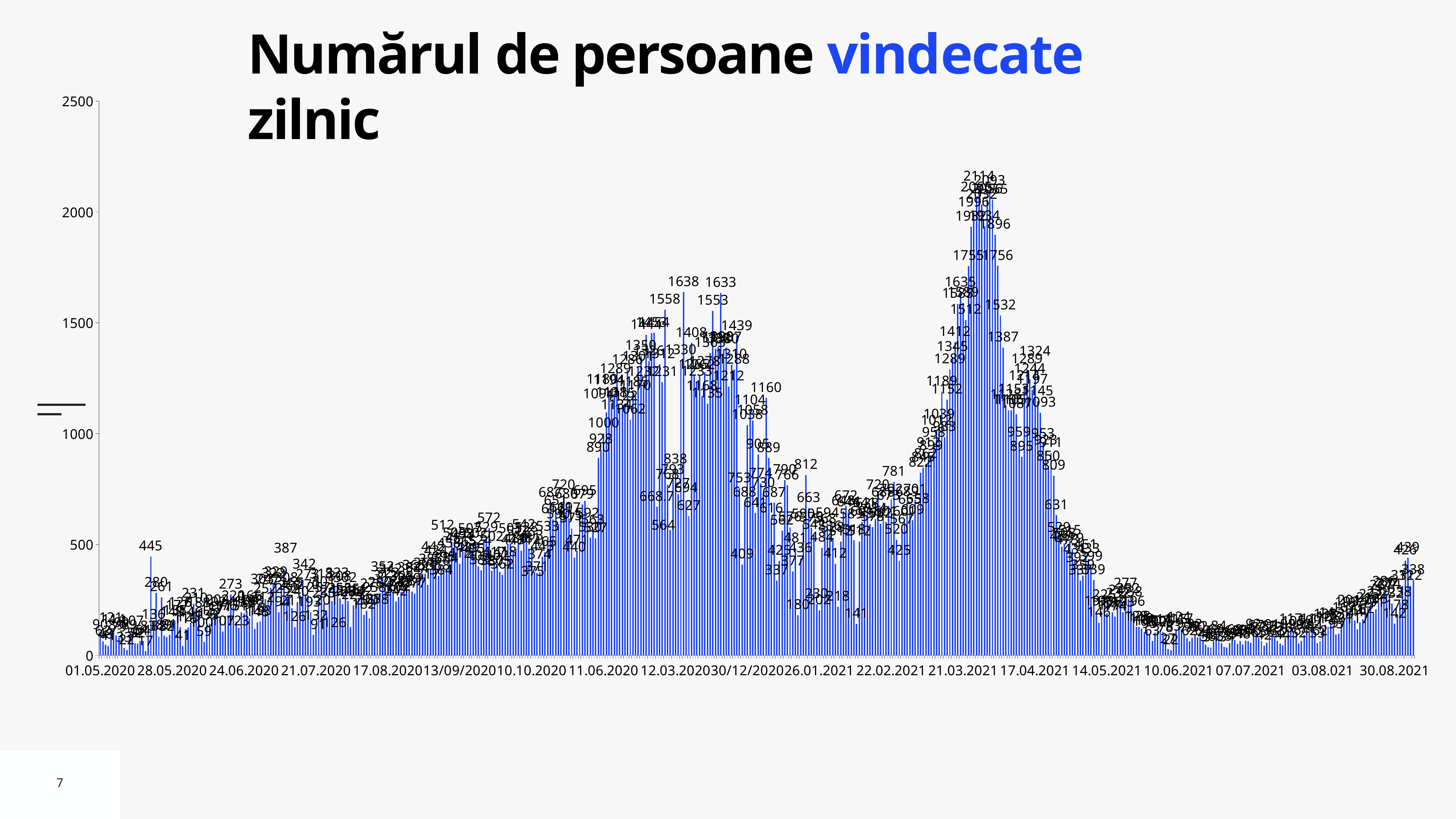
Is the first bar at 01.05.2020 greater or less than 500? less Do the values rise or fall between 10.06.2021 and 30.08.2021? rise Do the values rise or fall between 17.04.2021 and 14.05.2021? fall What is the highest value printed as a data label on the chart? 2114 Which peak is higher: the one between 21.03.2021 and 17.04.2021 or the one between 11.06.2020 and 30/12/2020? the one between 21.03.2021 and 17.04.2021 Is the tallest bar between 21.03.2021 and 17.04.2021 greater or less than 1500? greater Is the tallest bar on the chart greater or less than 2000? greater What kind of chart is shown on the slide? bar chart What is the title of the chart on the slide? Numărul de persoane vindecate zilnic Do the values rise or fall between 22.02.2021 and 21.03.2021? rise What is the maximum value shown on the vertical axis? 2500